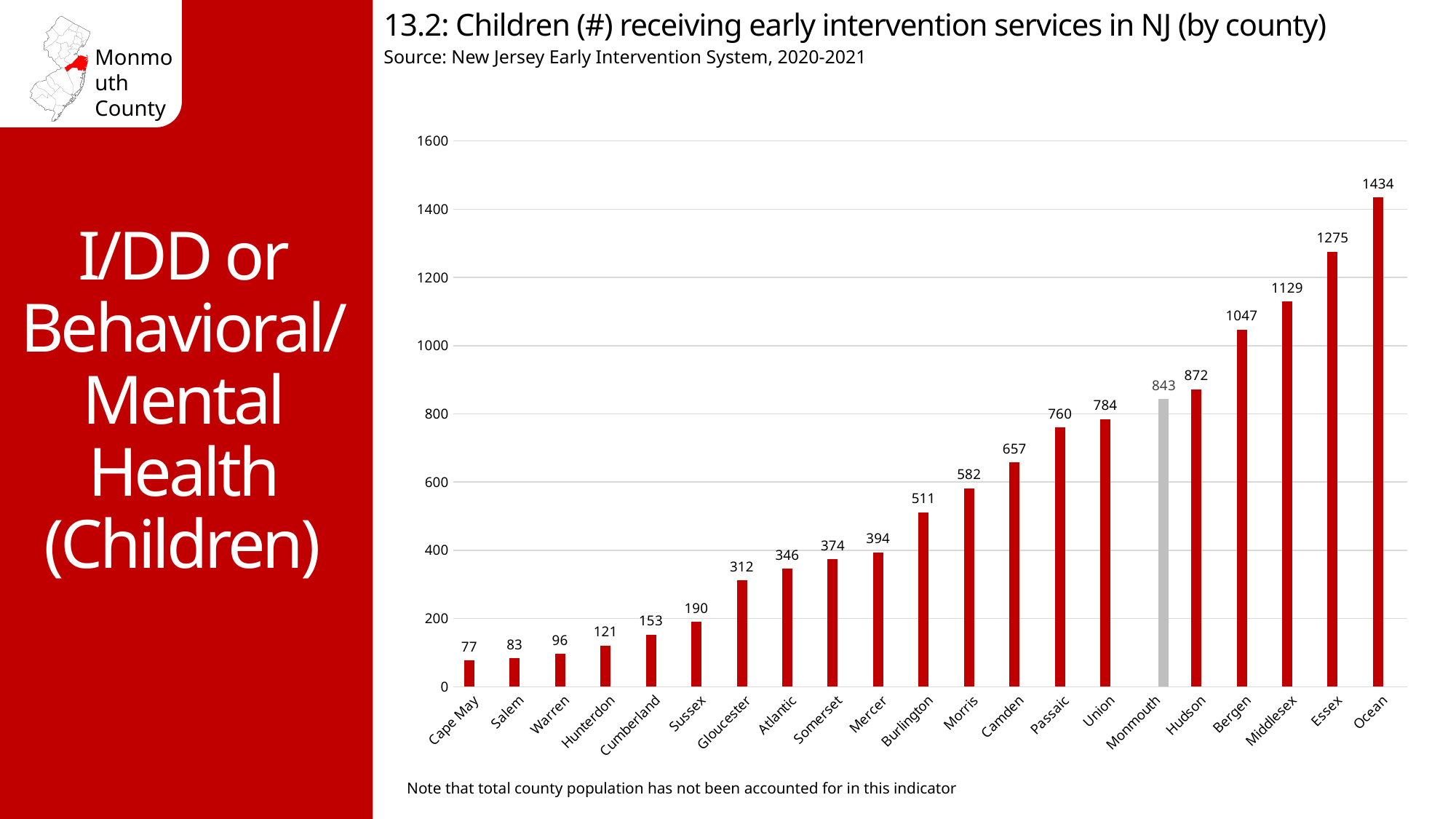
How many counties are shown on the chart? 21 What is the value shown for Camden? 657 Which county has a larger value, Hudson or Monmouth? Hudson What is the difference between the values for Union and Passaic? 24 Which county's bar is shown in grey rather than red? Monmouth What kind of chart is shown on the slide? Bar chart What is the difference between the values for Ocean and Essex? 159 Which county has the lowest number of children receiving early intervention services? Cape May Is the value for Bergen greater or less than 1000? greater How many children in Monmouth County received early intervention services? 843 Which county has the highest number of children receiving early intervention services? Ocean Do the values rise or fall moving from left to right along the x axis? Rise